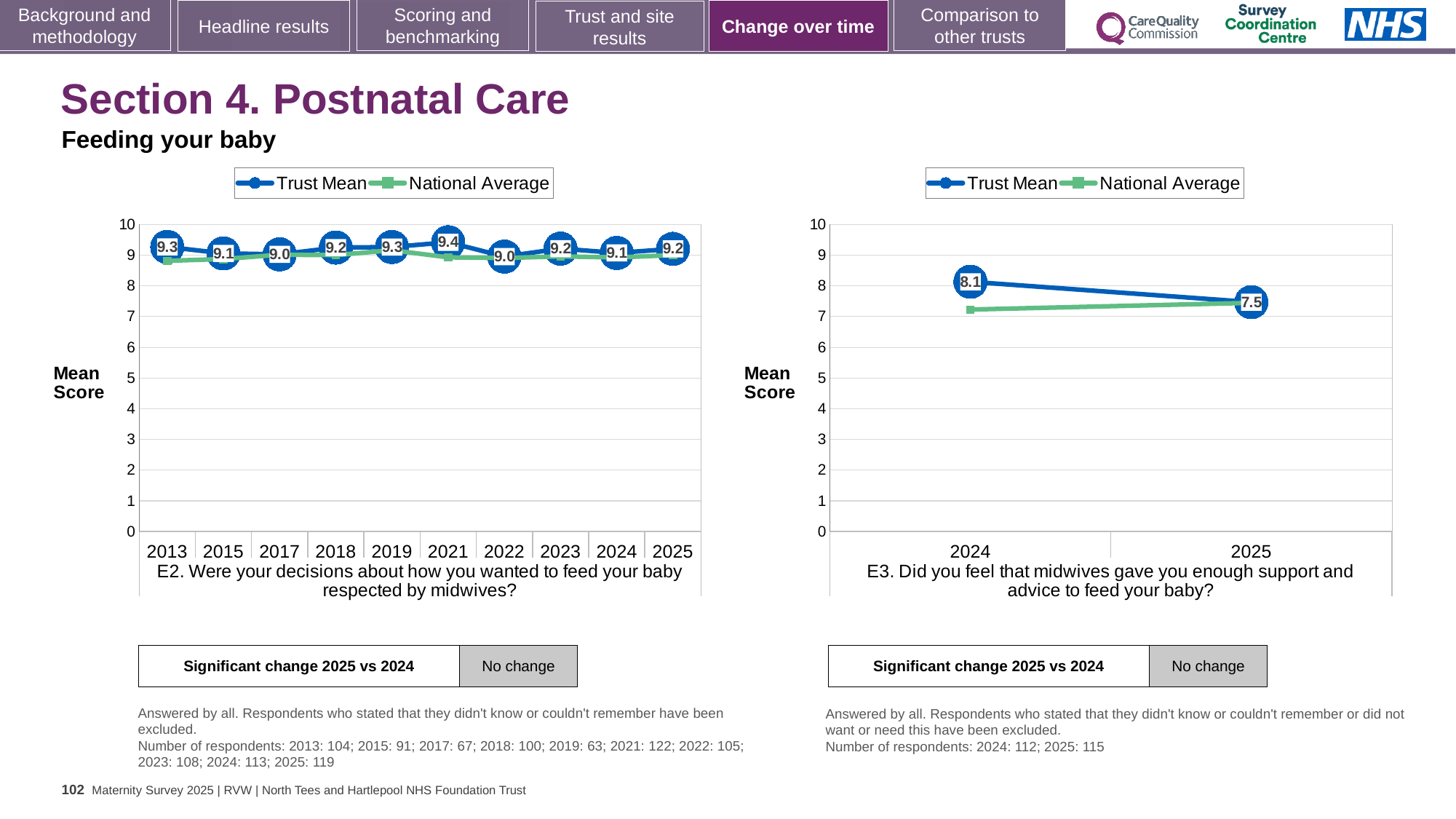
In the right chart (E3), is the Trust Mean higher in 2024 or in 2025? 2024 In the left chart (E2), what is the Trust Mean for 2013? 9.3 In the left chart (E2), what is the Trust Mean for 2021? 9.4 In the left chart (E2), which year has the highest Trust Mean? 2021 In the left chart (E2), what is the difference between the Trust Mean in 2021 and in 2022? 0.4 What kind of chart is the left chart (E2)? Line chart In the right chart (E3), what is the difference between the Trust Mean in 2024 and in 2025? 0.6 In the right chart (E3), is the National Average for 2024 greater or less than 8? less In the right chart (E3), what is the Trust Mean for 2025? 7.5 How many series does the legend of the right chart (E3) list? 2 In the right chart (E3), does the Trust Mean rise or fall from 2024 to 2025? Fall How many years are shown on the x axis of the left chart (E2)? 10